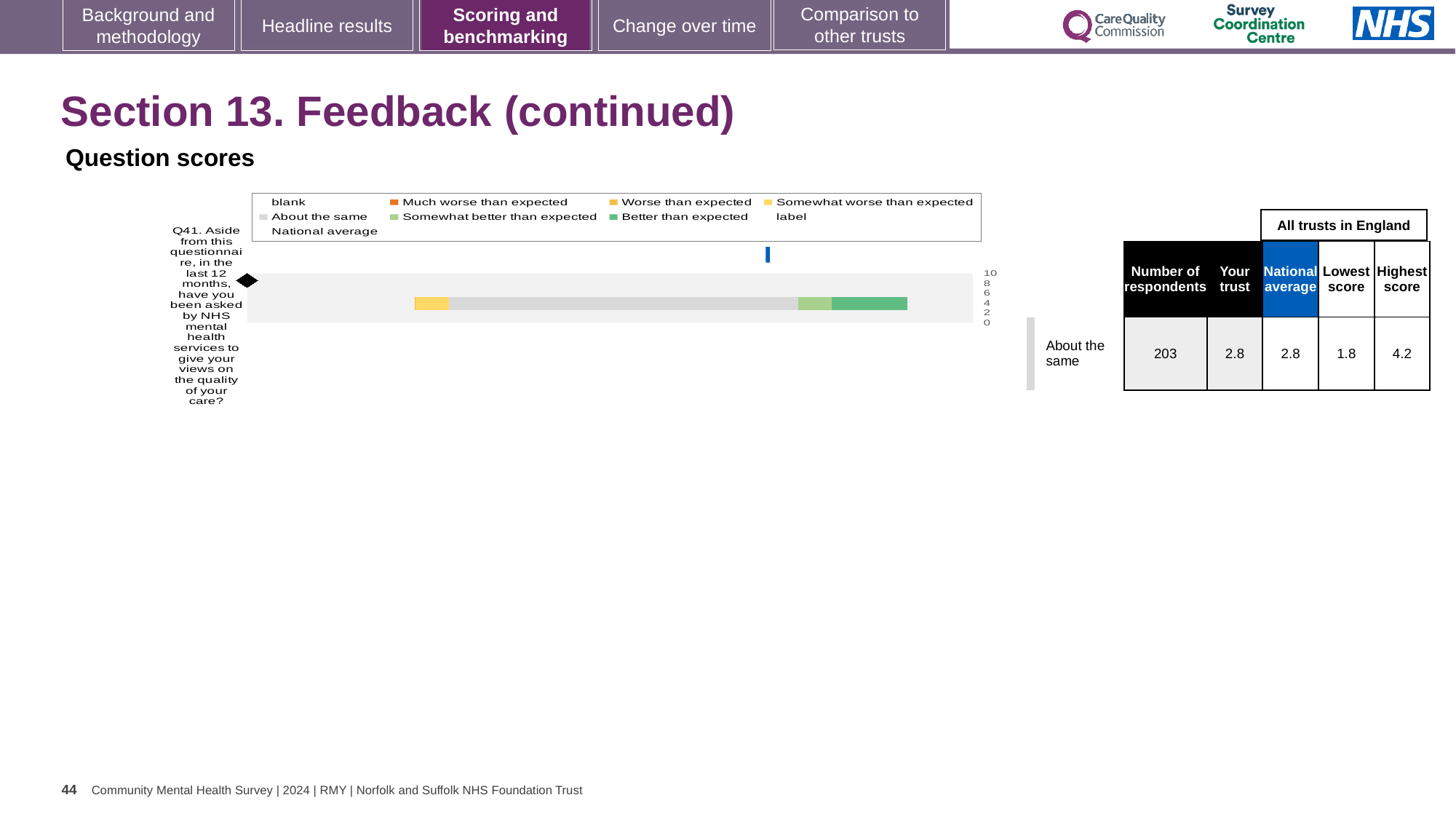
Which segment of the Q41 bar is the widest? About the same In the table next to the chart, what is the difference between the highest score and the lowest score for Q41? 2.4 In the table next to the chart, what is the national average score for Q41? 2.8 Is the 'Better than expected' segment of the Q41 bar wider or narrower than the 'Somewhat better than expected' segment? wider In the table next to the chart, what is the number of respondents for Q41? 203 In the table next to the chart, what is the 'Your trust' score for Q41? 2.8 What kind of chart is shown on the slide for Q41? bar chart According to the table next to the chart, how is the trust's Q41 score categorised relative to expectation? About the same What colour is the 'About the same' segment in the chart legend? grey How many questions are plotted in the chart? 1 What colour is the 'Much worse than expected' entry in the chart legend? orange Is the 'About the same' segment of the Q41 bar wider or narrower than the 'Worse than expected' segment? wider